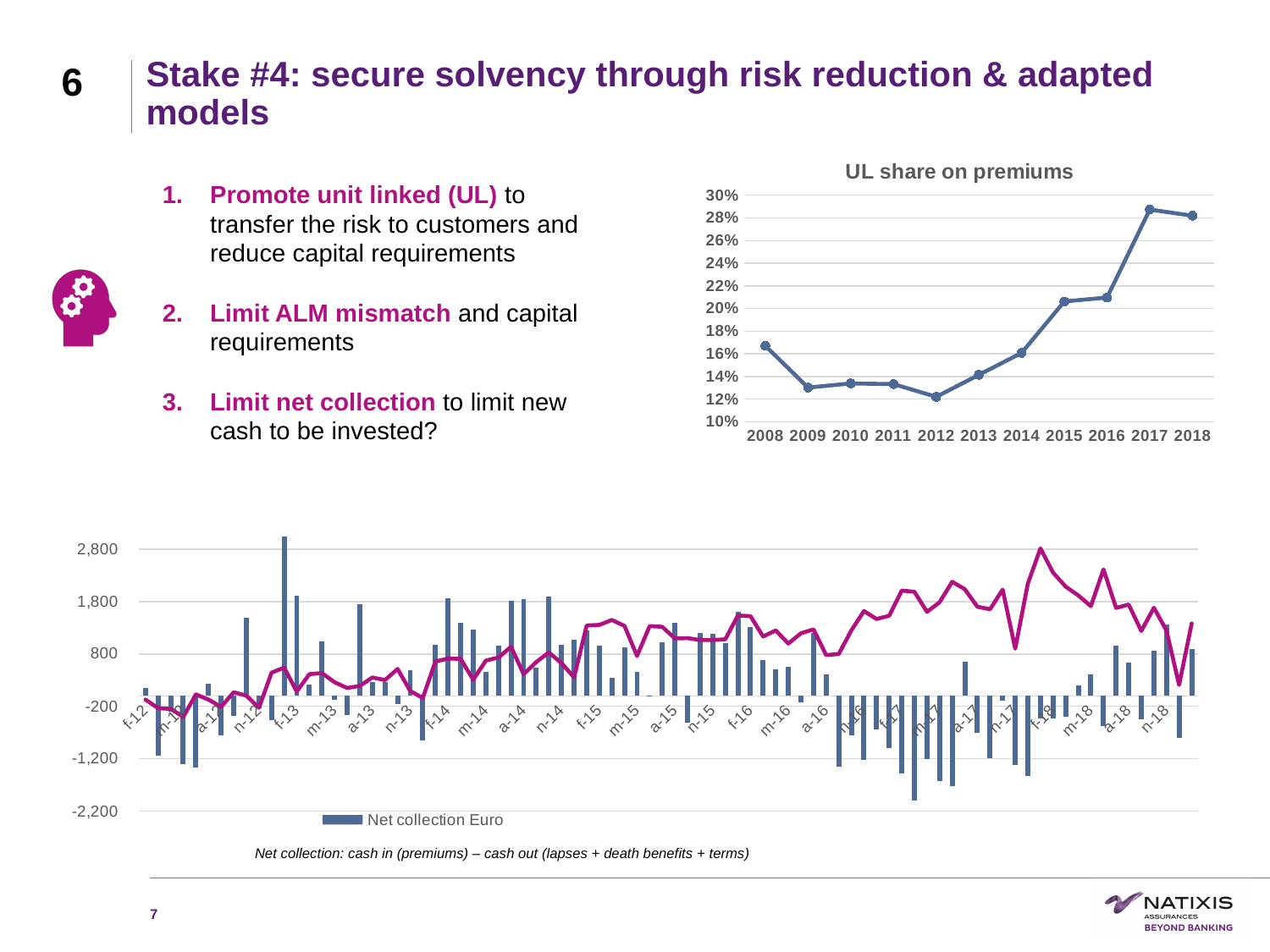
In the 'UL share on premiums' chart, is the value for 2008 greater or less than 16%? greater In the 'UL share on premiums' chart, which year has the lowest UL share? 2012 In the 'UL share on premiums' chart, do the values generally rise or fall from 2012 to 2017? Rise In the bottom chart, how many series does the legend list? 1 In the 'UL share on premiums' chart, which year has the larger UL share, 2014 or 2016? 2016 In the 'UL share on premiums' chart, which year has the highest UL share? 2017 In the bottom chart, what series name does the legend show? Net collection Euro In the 'UL share on premiums' chart, is the value for 2015 greater or less than 20%? greater In the 'UL share on premiums' chart, is the value for 2012 greater or less than 14%? less In the 'UL share on premiums' chart, how many years are plotted on the x axis? 11 What kind of chart is the 'UL share on premiums' chart? Line chart